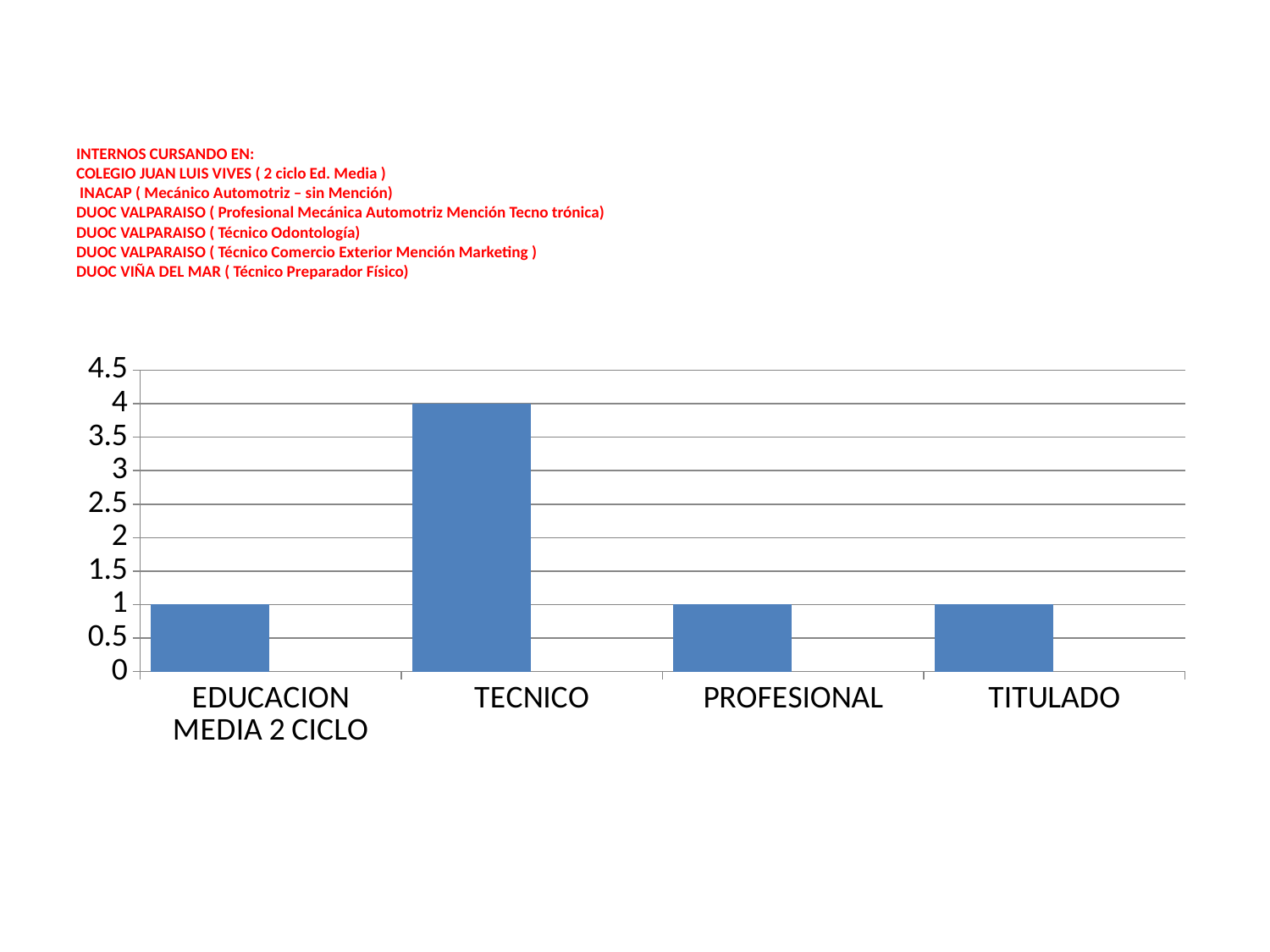
Is the value for TECNICO greater or less than 3? greater What kind of chart is shown on the slide? bar chart What is the value for TECNICO? 4 What is the value for EDUCACION MEDIA 2 CICLO? 1 What is the value for PROFESIONAL? 1 How many categories are shown on the x axis? 4 Which is larger, the value for TECNICO or the value for TITULADO? TECNICO What is the highest value shown on the vertical axis? 4.5 What is the value for TITULADO? 1 What is the difference between the values for TECNICO and PROFESIONAL? 3 Is the value for EDUCACION MEDIA 2 CICLO greater or less than 2? less Which category has the highest value? TECNICO